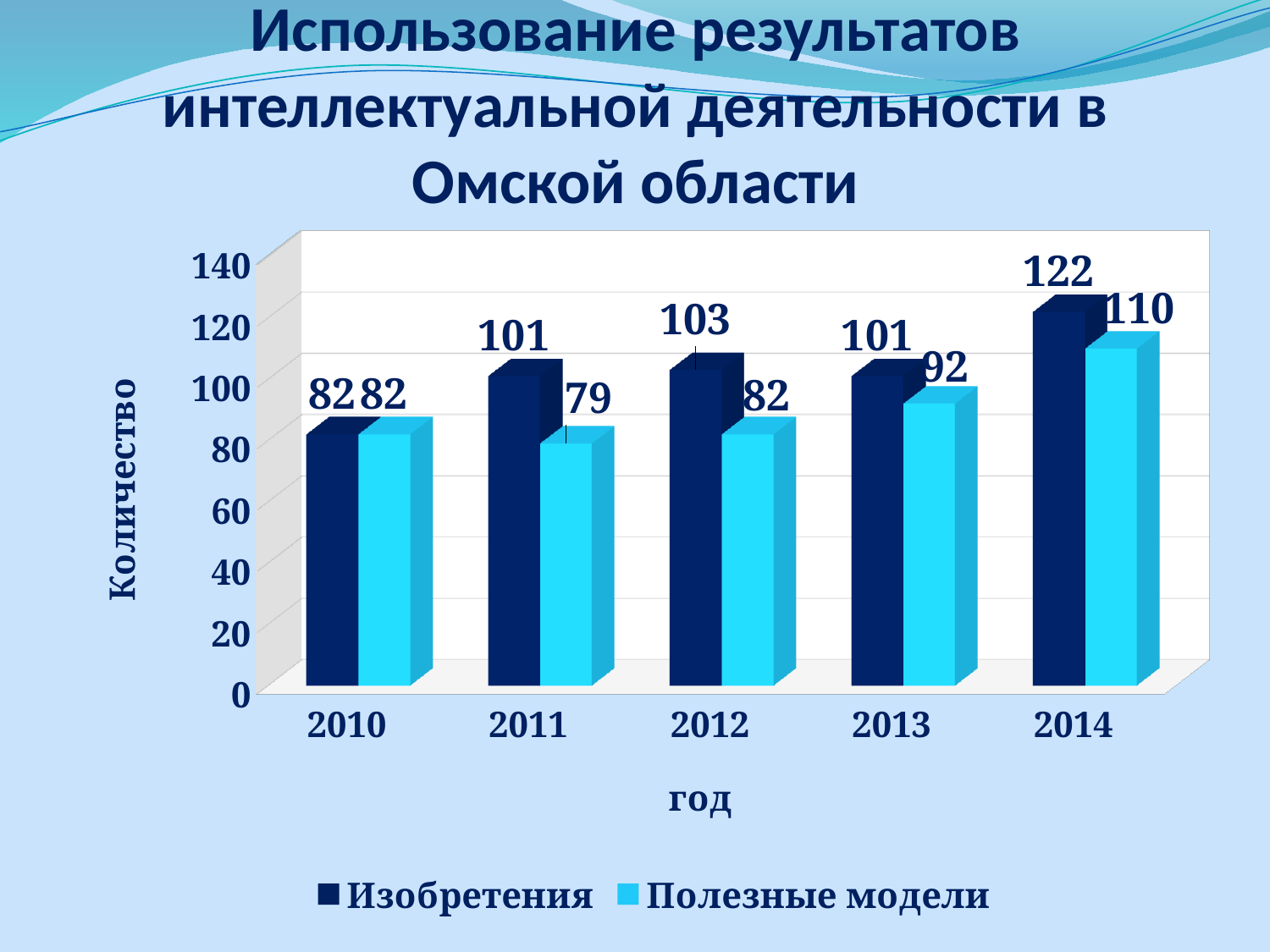
What is the label of the y axis? Количество How many years are shown on the x axis? 5 What is the value for Полезные модели in 2013? 92 Which is larger in 2013: Изобретения or Полезные модели? Изобретения What is the difference between Изобретения and Полезные модели in 2012? 21 What is the value for Полезные модели in 2011? 79 Is the value for Полезные модели in 2014 greater or less than 100? greater How many series does the legend list? 2 What kind of chart is shown on the slide? bar chart Which year has the highest value for Изобретения? 2014 What is the value for Изобретения in 2014? 122 Which year has the lowest value for Полезные модели? 2011